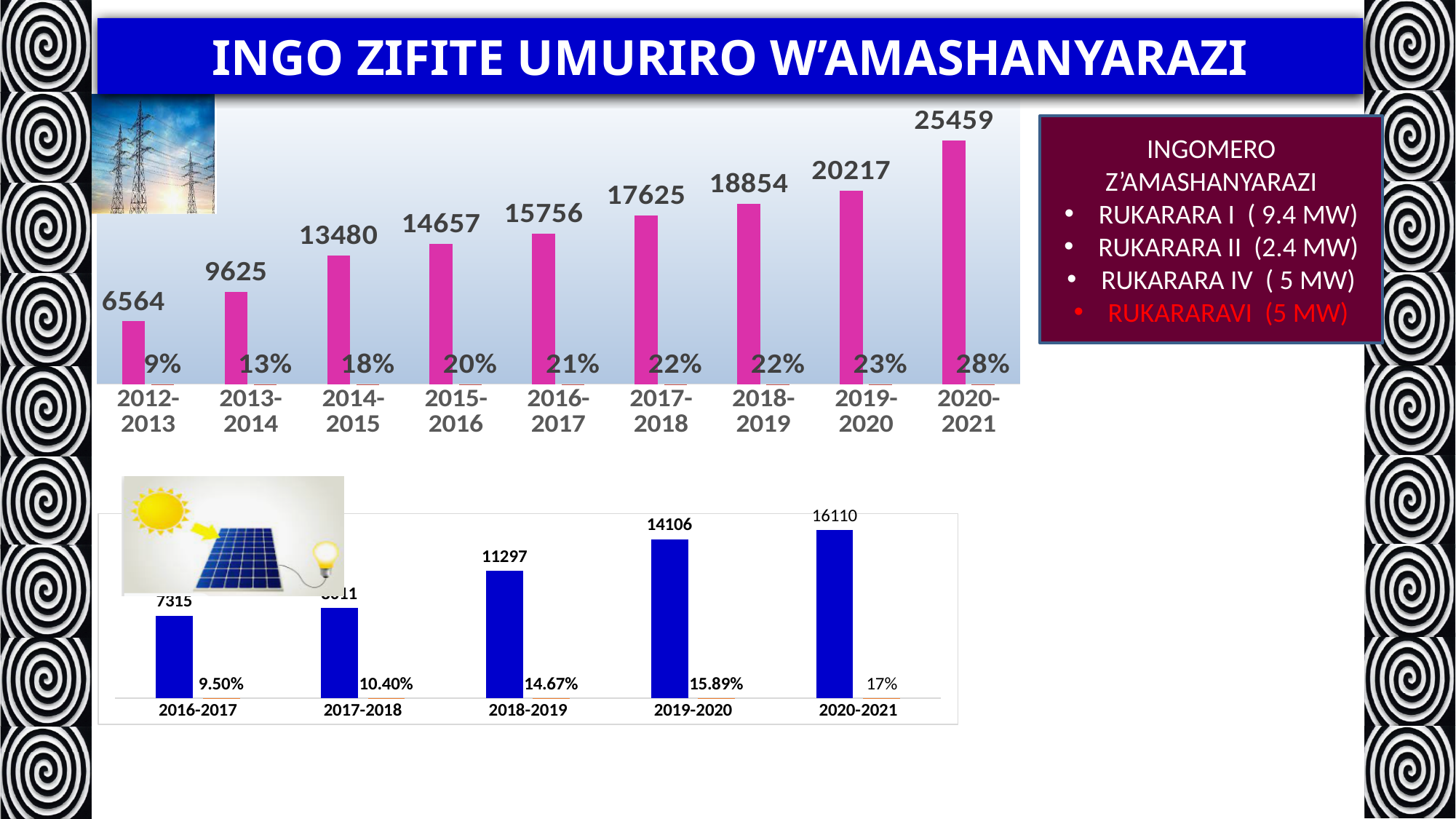
In the top chart, what is the value for 2012-2013? 6564 In the bottom chart, what is the value for 2019-2020? 14106 In the top chart, do the values rise or fall from 2012-2013 to 2020-2021? rise In the top chart, what is the value for 2020-2021? 25459 In the top chart, which period has the highest value? 2020-2021 In the top chart, what is the difference between the values for 2020-2021 and 2019-2020? 5242 In the top chart, what percentage is shown for 2015-2016? 20% In the top chart, how many periods are shown on the x axis? 9 In the bottom chart, what is the difference between the values for 2020-2021 and 2016-2017? 8795 What kind of chart is the bottom chart? bar chart In the top chart, which period has the lowest value? 2012-2013 In the bottom chart, what percentage is shown for 2018-2019? 14.67%